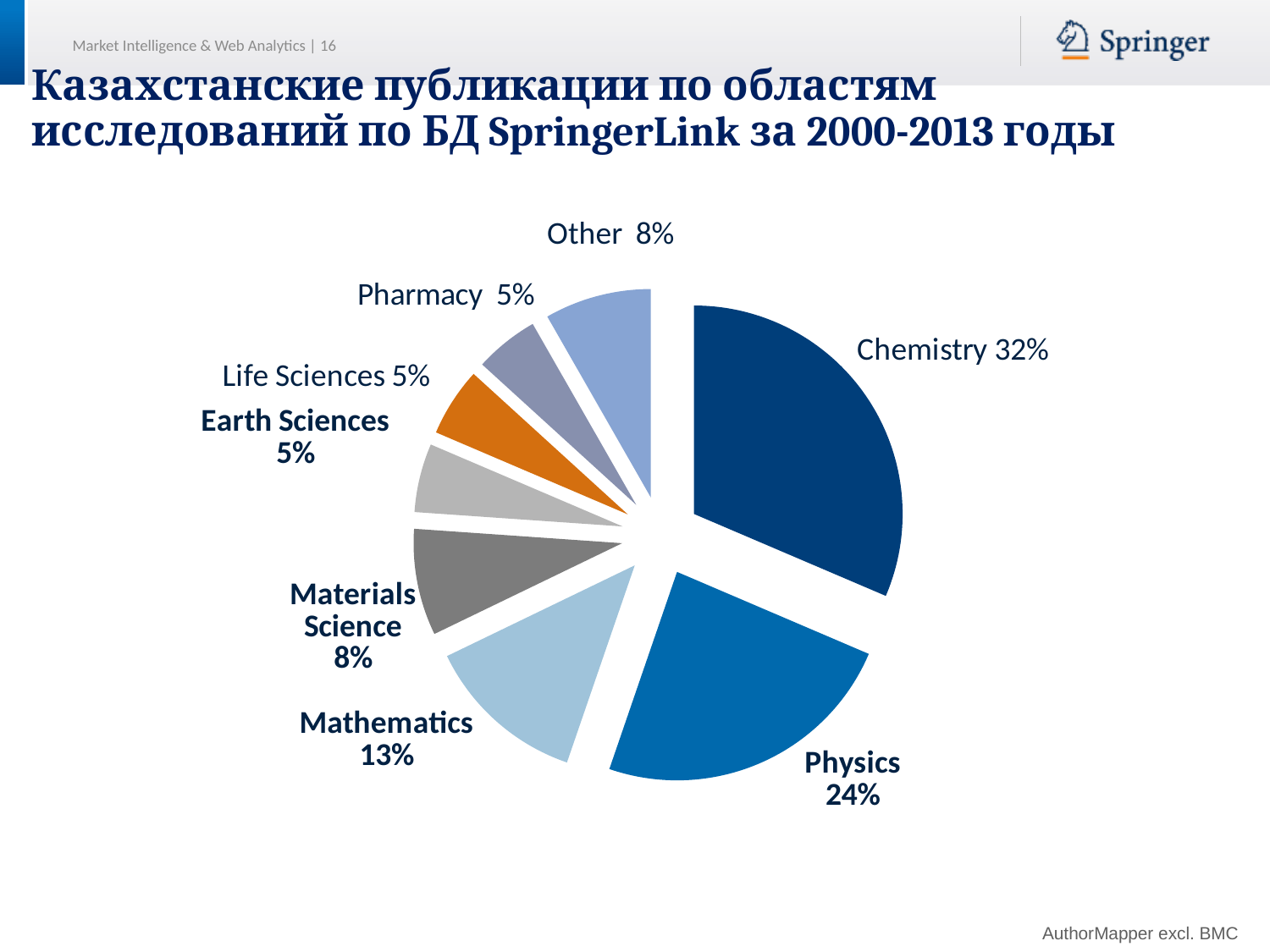
Which is larger, the share for Physics or the share for Mathematics? Physics What is the difference between the Mathematics and Materials Science shares? 5% What is the value shown for Materials Science? 8% What is the value shown for Mathematics? 13% What is the value shown for Physics? 24% Which category has the largest slice of the pie? Chemistry What share of the pie does Chemistry have? 32% What kind of chart is shown on the slide? pie chart How many slices does the pie chart have? 8 What is the difference between the Chemistry and Physics shares? 8% Which three categories each have a share of 5%? Earth Sciences, Life Sciences, Pharmacy What is the value shown for Pharmacy? 5%